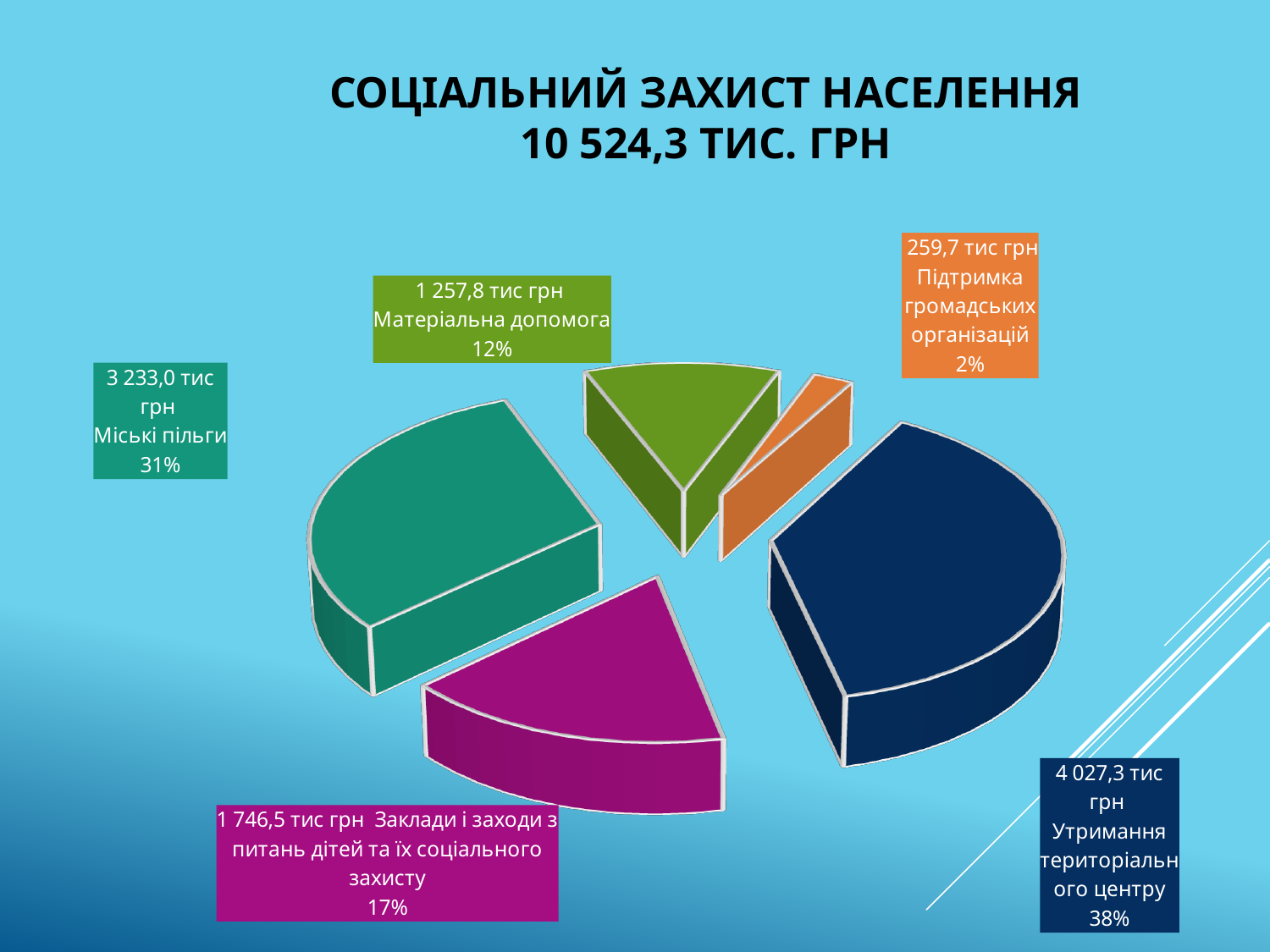
What share of the pie does Міські пільги represent? 31% What type of chart is shown on the slide? Pie chart Which category has the smallest slice of the pie? Підтримка громадських організацій Which is larger, Міські пільги or Матеріальна допомога? Міські пільги What total amount is stated in the chart title? 10 524,3 тис. грн How many slices does the pie chart have? 5 What share of the pie does Заклади і заходи з питань дітей та їх соціального захисту represent? 17% What is the value for Міські пільги? 3 233,0 тис грн What is the value for Матеріальна допомога? 1 257,8 тис грн What is the value for Утримання територіального центру? 4 027,3 тис грн What is the value for Підтримка громадських організацій? 259,7 тис грн Which category has the largest slice of the pie? Утримання територіального центру